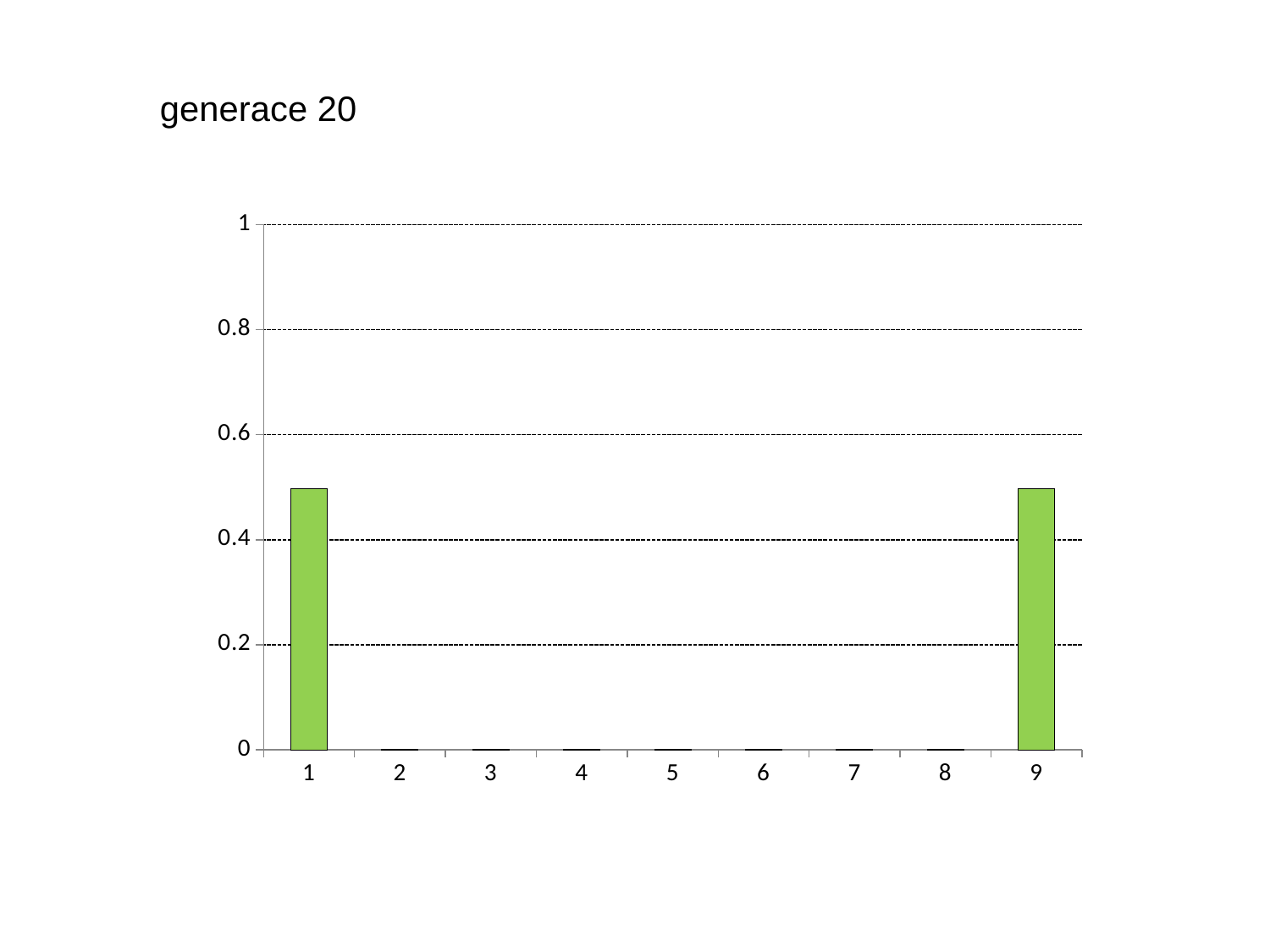
How many categories are shown on the x axis of the chart? 9 Is the value for category 9 greater or less than 0.6? less What colour are the bars in the chart? green Is the value for category 1 greater or less than 0.4? greater Is the value for category 5 greater or less than 0.2? less Which has the larger value, category 1 or category 2? 1 What is the highest value shown on the y axis? 1 Which has the larger value, category 9 or category 8? 9 What is the title of the slide above the chart? generace 20 What kind of chart is shown on the slide? bar chart